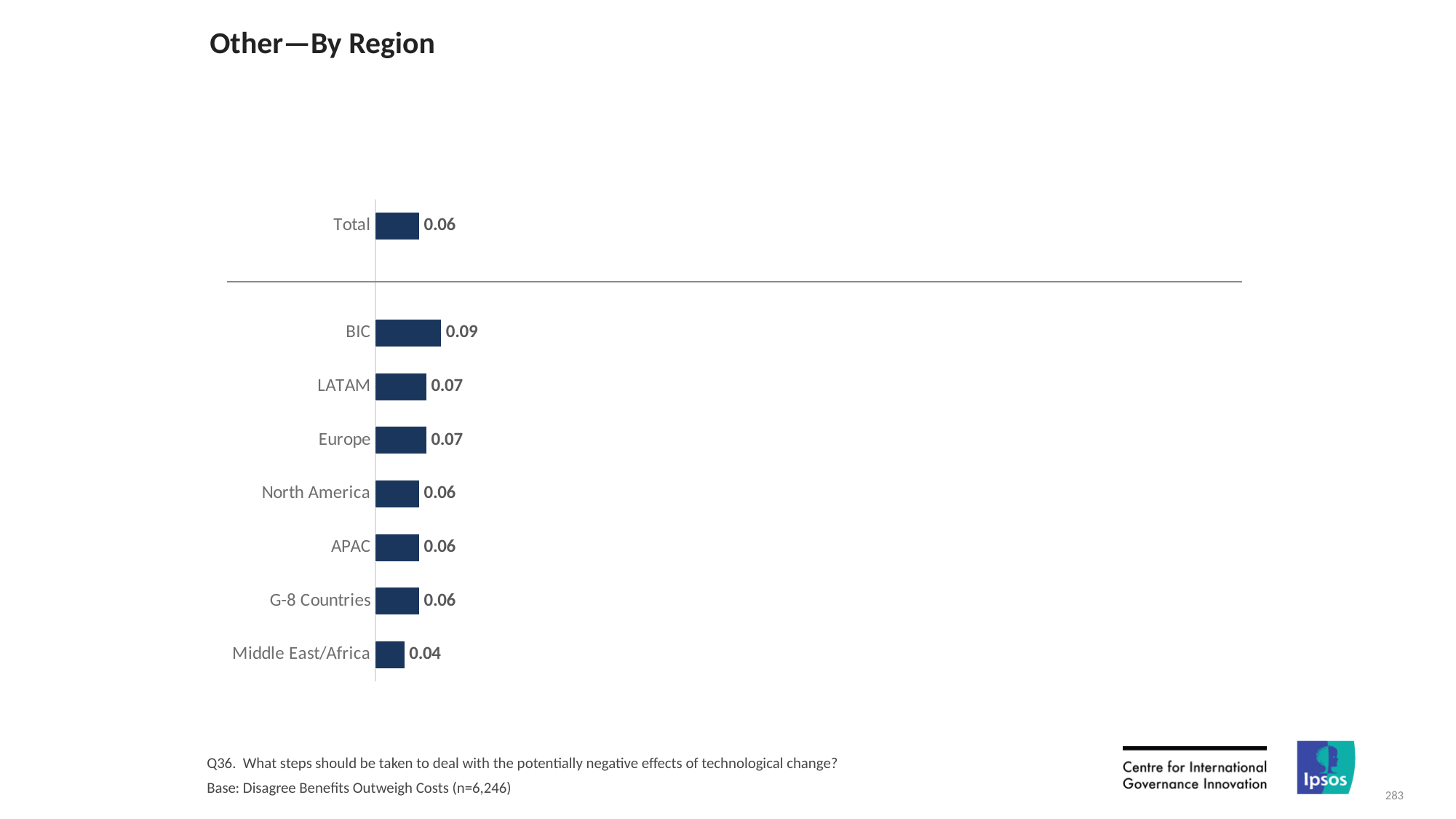
How many bars are shown in the chart, including Total? 8 What is the difference between the values for Europe and North America? 0.01 What is the value for Middle East/Africa? 0.04 What is the value for BIC? 0.09 What is the title of the slide? Other—By Region What kind of chart is shown on the slide? bar chart Which is larger, the value for BIC or the value for APAC? BIC Which region has the lowest value? Middle East/Africa What is the difference between the values for BIC and Middle East/Africa? 0.05 What is the value for Total? 0.06 What is the value for LATAM? 0.07 Which region has the highest value? BIC